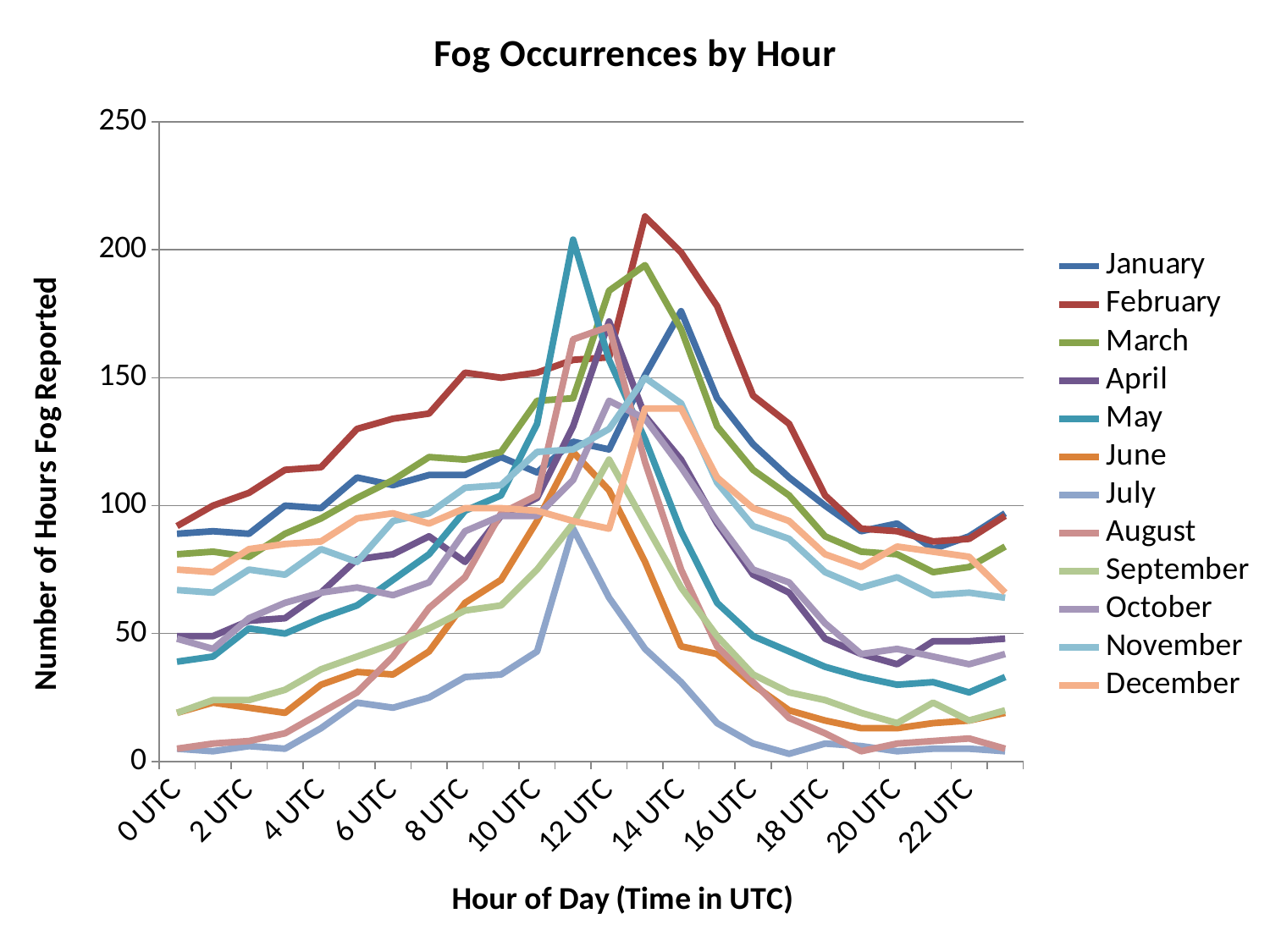
How many series does the legend list? 12 Which month's line reaches the highest value anywhere on the chart? February Is the value for February at 13 UTC greater or less than 200? greater Is the value for July at 12 UTC greater or less than 100? less Does the July line rise or fall between 12 UTC and 17 UTC? fall What kind of chart is shown on the slide? line chart Which month has the highest value at 11 UTC? May Which month has the highest value at 14 UTC? February Which month has the lowest value at 17 UTC? July At 12 UTC, which is larger, the value for February or the value for June? February What is the title of the chart? Fog Occurrences by Hour What is the label of the vertical axis? Number of Hours Fog Reported